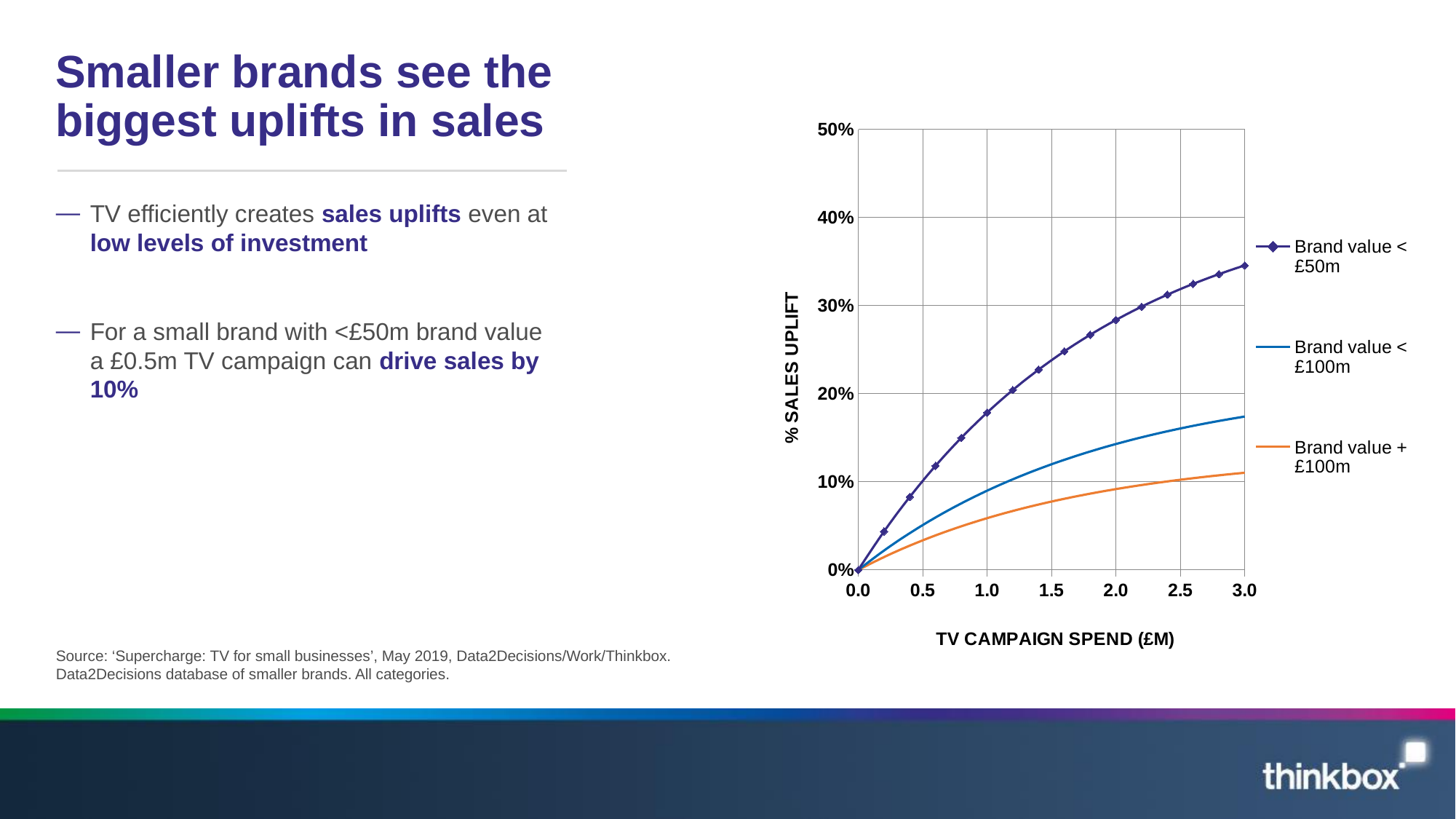
What is the % sales uplift for all three series at a TV campaign spend of 0.0? 0% Which series shows the lowest % sales uplift across the range of TV campaign spend? Brand value + £100m What are the three series named in the chart legend? Brand value < £50m, Brand value < £100m, Brand value + £100m At a TV campaign spend of 2.0, which series shows the higher % sales uplift: Brand value < £50m or Brand value + £100m? Brand value < £50m What kind of chart is shown on the slide? line chart Is the % sales uplift for Brand value < £100m at a spend of 3.0 greater or less than 20%? less Is the % sales uplift for Brand value < £50m at a spend of 3.0 greater or less than 30%? greater Which series reaches the highest % sales uplift at a spend of 3.0? Brand value < £50m Is the % sales uplift for Brand value + £100m at a spend of 3.0 greater or less than 20%? less How many series does the chart legend list? 3 What is the title of the chart's x axis? TV CAMPAIGN SPEND (£M)